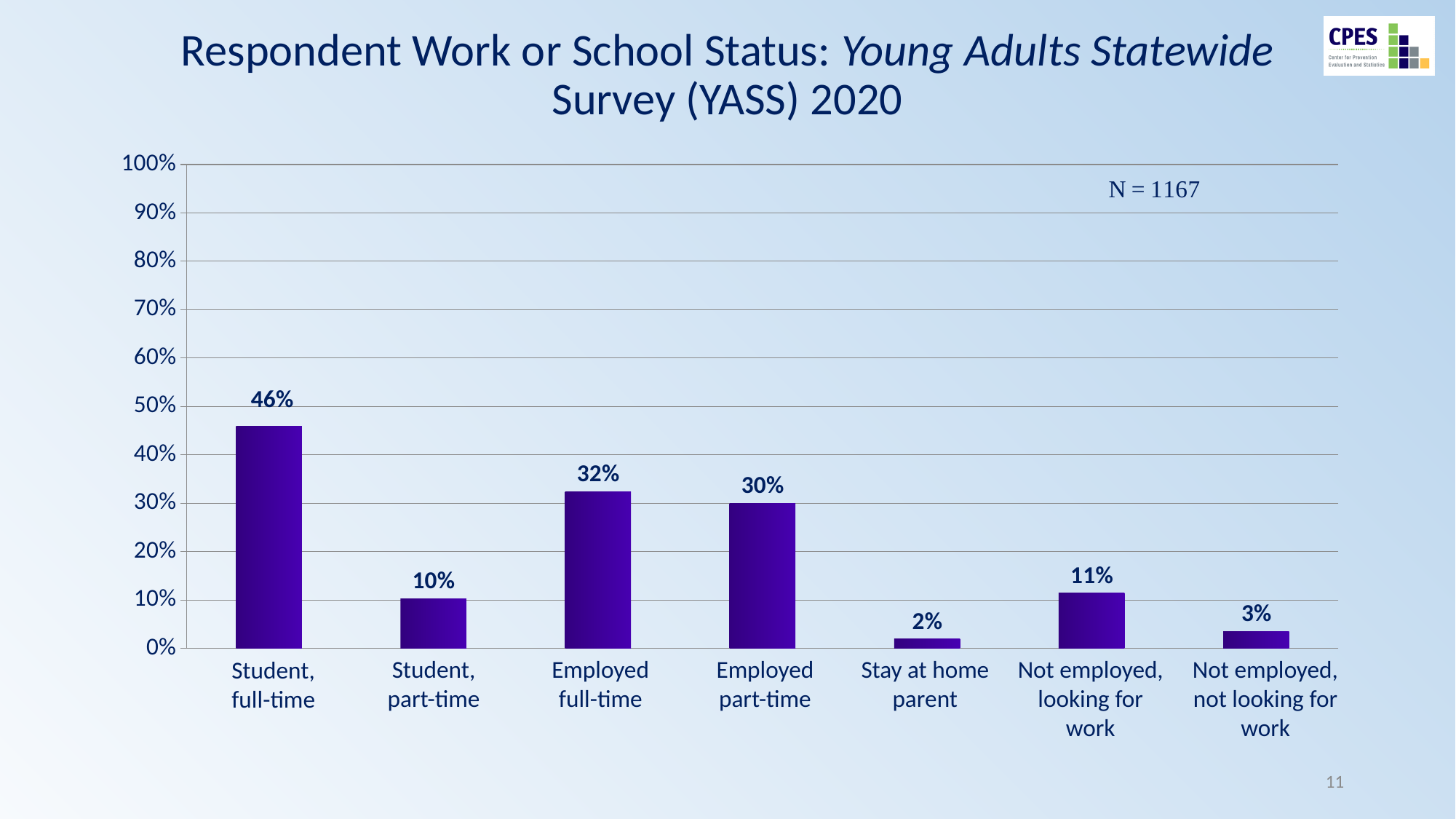
What is the sample size (N) shown on the chart? N = 1167 Which category has the lowest value? Stay at home parent What percentage of respondents are full-time students? 46% Which is larger: 'Student, part-time' or 'Not employed, looking for work'? Not employed, looking for work What percentage of respondents are stay at home parents? 2% Which category has the highest value? Student, full-time What is the value for 'Employed part-time'? 30% What kind of chart is shown on the slide? bar chart What is the value for 'Not employed, looking for work'? 11% Is the value for 'Employed full-time' greater or less than 40%? less How many categories are shown on the x axis? 7 What is the difference between 'Student, full-time' and 'Employed full-time'? 14%